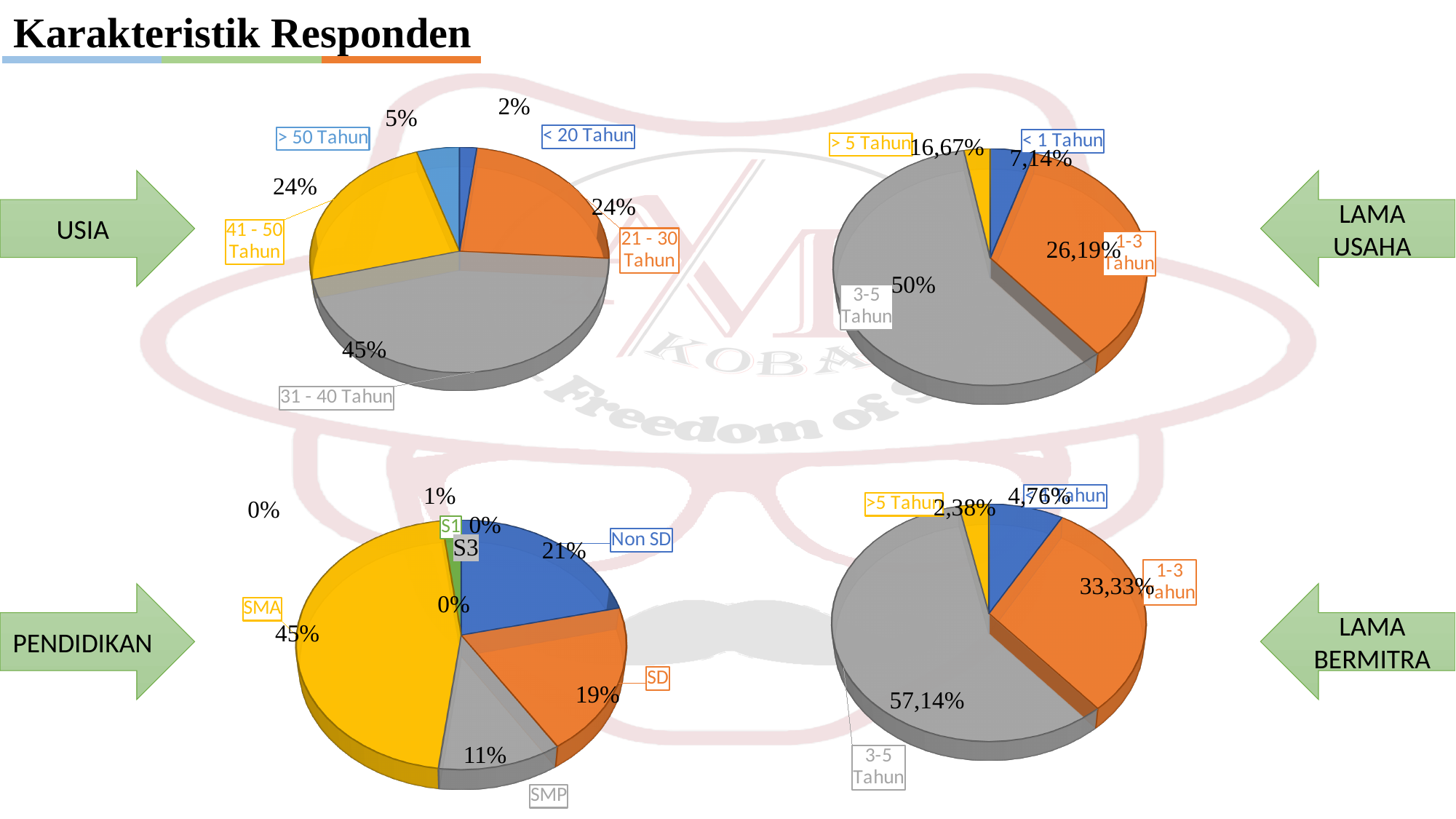
In the USIA pie chart, what is the share for > 50 Tahun? 5% In the LAMA USAHA pie chart, what is the share for 3-5 Tahun? 50% In the USIA pie chart, which age category has the smallest share? < 20 Tahun In the PENDIDIKAN pie chart, what is the share for SMP? 11% In the LAMA USAHA pie chart, what is the share for 1-3 Tahun? 26,19% In the LAMA USAHA pie chart, which category has the largest share? 3-5 Tahun In the PENDIDIKAN pie chart, what is the share for SMA? 45% In the LAMA USAHA pie chart, what is the difference between the shares for > 5 Tahun and < 1 Tahun? 9,53% In the LAMA BERMITRA pie chart, what is the share for 1-3 Tahun? 33,33% In the PENDIDIKAN pie chart, which is larger, the share for Non SD or the share for SD? Non SD What kind of chart is used for LAMA BERMITRA? Pie chart In the USIA pie chart, what percentage of respondents are 31 - 40 Tahun? 45%